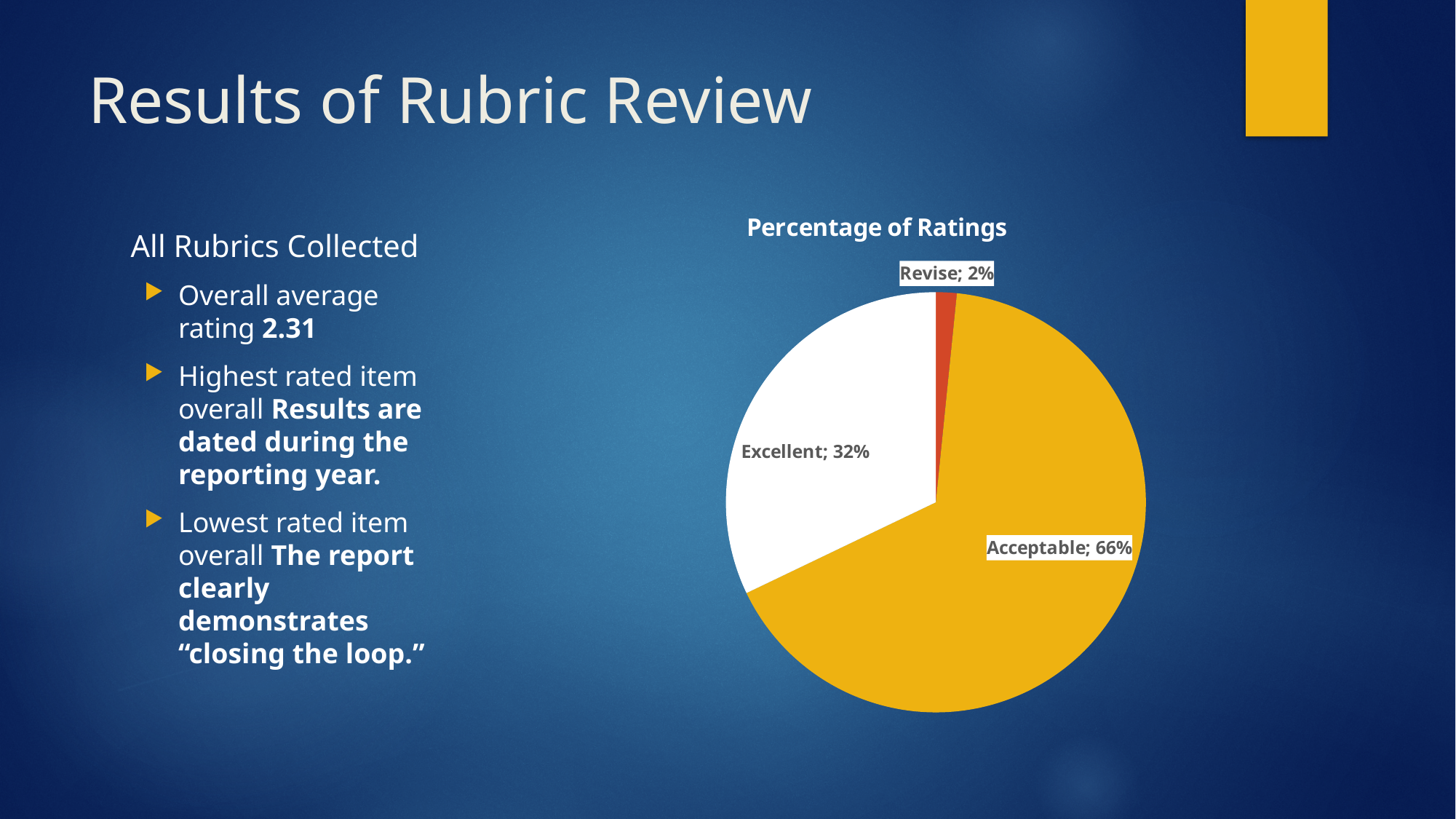
What is the title of the chart? Percentage of Ratings What percentage of ratings were Acceptable? 66% Which rating category has the smallest share of the pie? Revise Which is larger, the Excellent slice or the Revise slice? Excellent What kind of chart is shown on the slide? pie chart What percentage of ratings were Excellent? 32% Which rating category has the largest share of the pie? Acceptable What is the combined share of the Excellent and Revise slices? 34% What percentage of ratings were Revise? 2% How many slices does the pie chart have? 3 What is the difference in percentage points between the Acceptable and Excellent slices? 34 What colour is the Acceptable slice? yellow